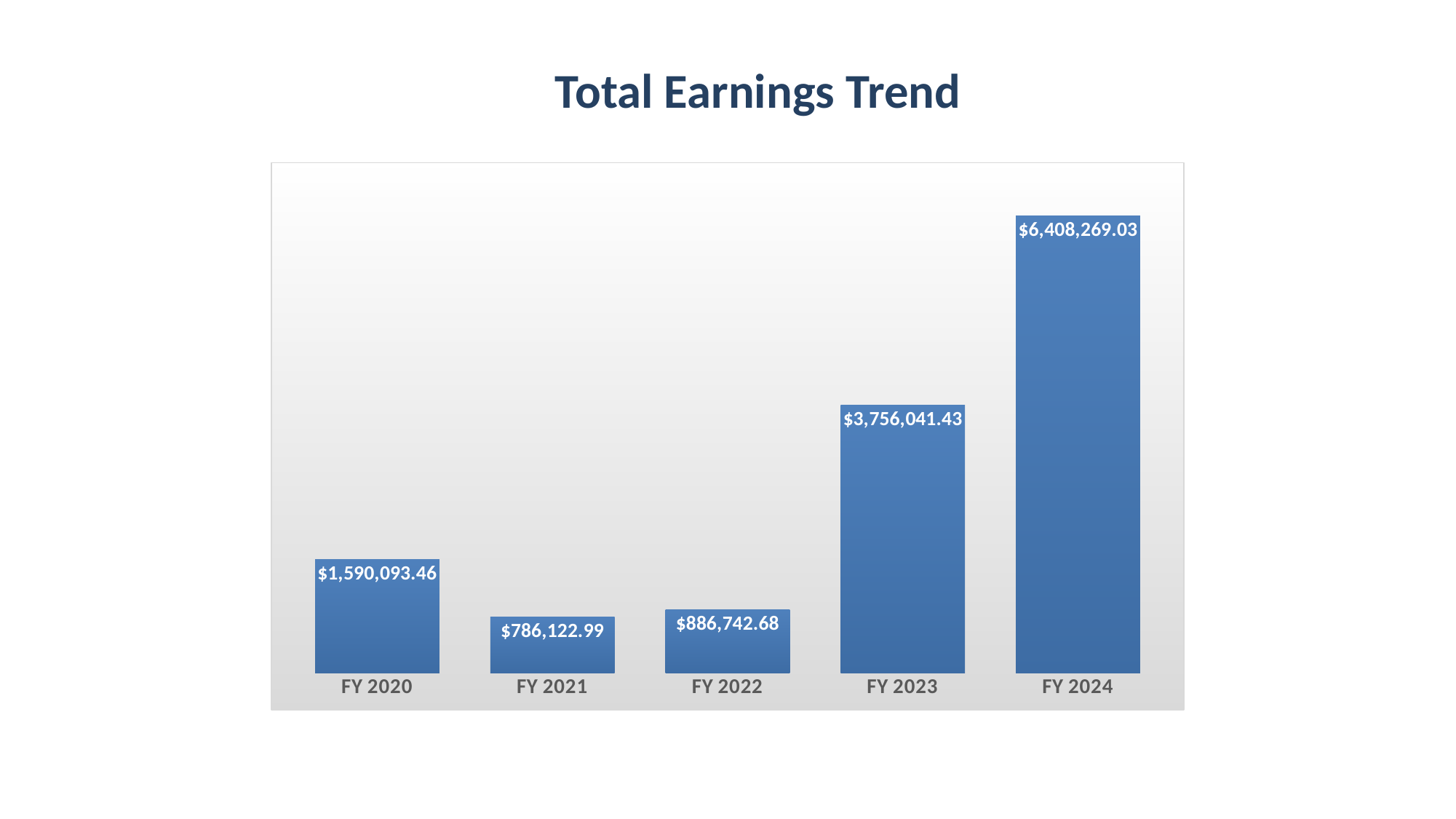
How many fiscal years are shown in the chart? 5 Which is larger, the total earnings for FY 2020 or FY 2022? FY 2020 What is the total earnings value for FY 2021? $786,122.99 What is the total earnings value for FY 2024? $6,408,269.03 Which fiscal year has the highest total earnings? FY 2024 What is the total earnings value for FY 2023? $3,756,041.43 Do the total earnings rise or fall from FY 2022 to FY 2024? Rise What is the total earnings value for FY 2020? $1,590,093.46 What is the difference between the total earnings for FY 2022 and FY 2021? $100,619.69 What is the difference between the total earnings for FY 2024 and FY 2023? $2,652,227.60 What kind of chart is shown on the slide? Bar chart Which fiscal year has the lowest total earnings? FY 2021